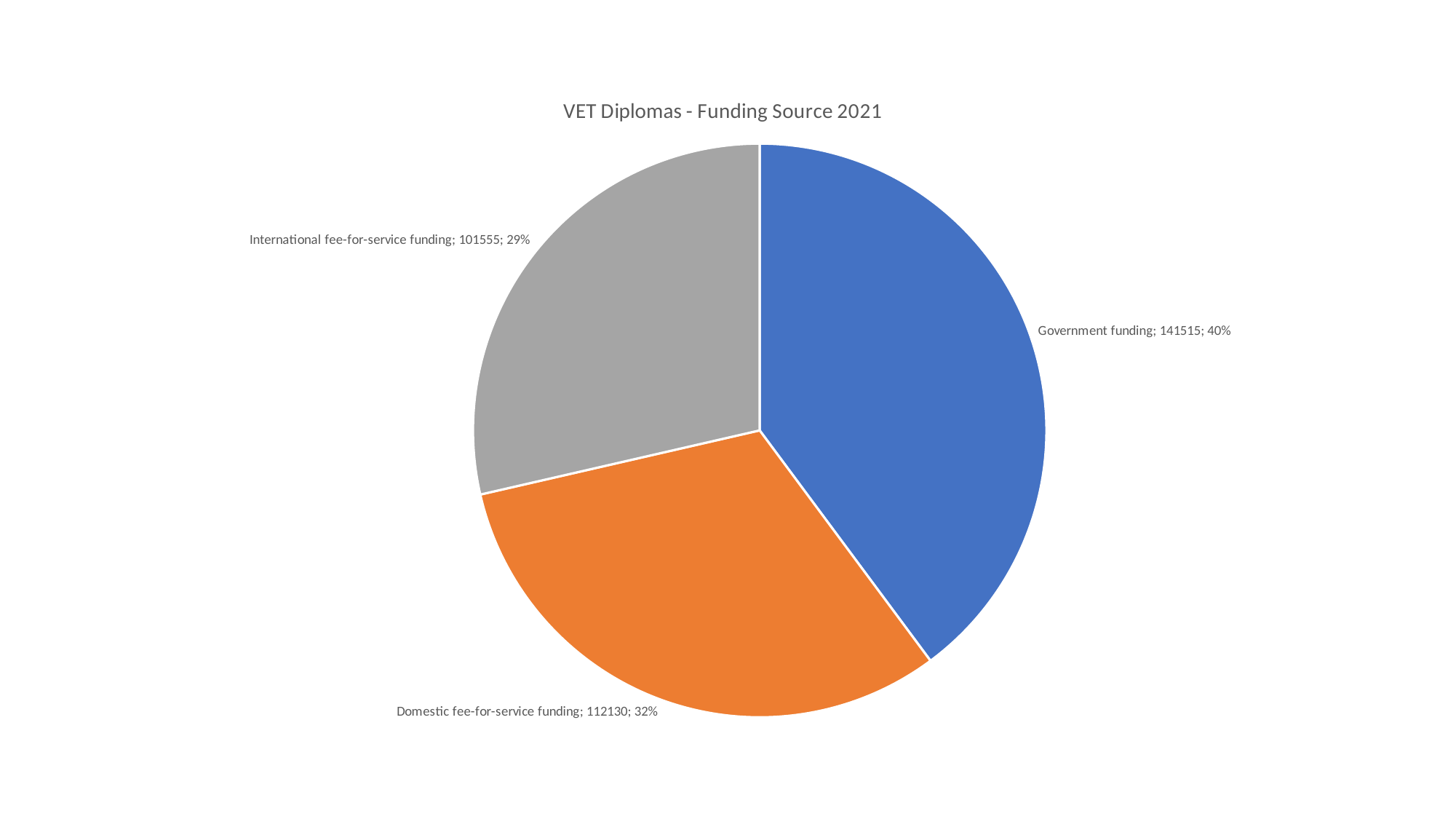
What is the difference between Government funding and Domestic fee-for-service funding? 29385 What share of the pie does Domestic fee-for-service funding represent? 32% What is the value for International fee-for-service funding? 101555 How many funding sources are shown in the pie chart? 3 Which is larger, Domestic fee-for-service funding or International fee-for-service funding? Domestic fee-for-service funding Which funding source has the largest slice? Government funding What is the title of the chart? VET Diplomas - Funding Source 2021 What is the value for Government funding? 141515 What kind of chart is shown on the slide? Pie chart What share of the pie does International fee-for-service funding represent? 29% What is the value for Domestic fee-for-service funding? 112130 Which funding source has the smallest slice? International fee-for-service funding